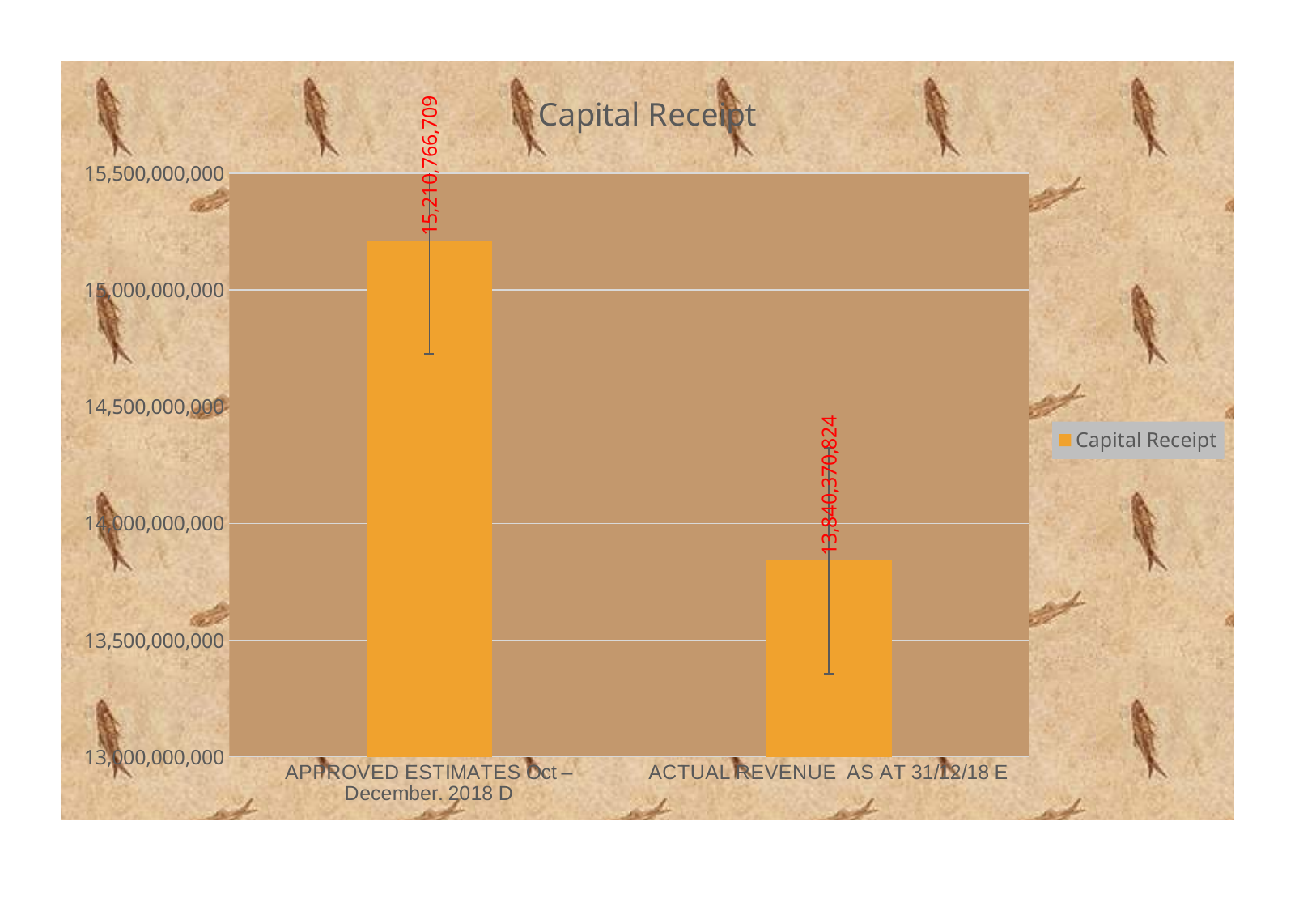
What is the title of the chart? Capital Receipt Is the value for ACTUAL REVENUE AS AT 31/12/18 E greater or less than 14,000,000,000? less Which category has the highest value? APPROVED ESTIMATES Oct – December. 2018 D What is the value for APPROVED ESTIMATES Oct – December. 2018 D? 15,210,766,709 Which is larger, the approved estimates or the actual revenue as at 31/12/18? APPROVED ESTIMATES Oct – December. 2018 D Which category has the lowest value? ACTUAL REVENUE AS AT 31/12/18 E What kind of chart is shown? bar chart How many series does the legend list? 1 What is the value for ACTUAL REVENUE AS AT 31/12/18 E? 13,840,370,824 Is the value for APPROVED ESTIMATES Oct – December. 2018 D greater or less than 15,000,000,000? greater How many categories are shown on the chart? 2 What is the difference between the approved estimates and the actual revenue? 1,370,395,885